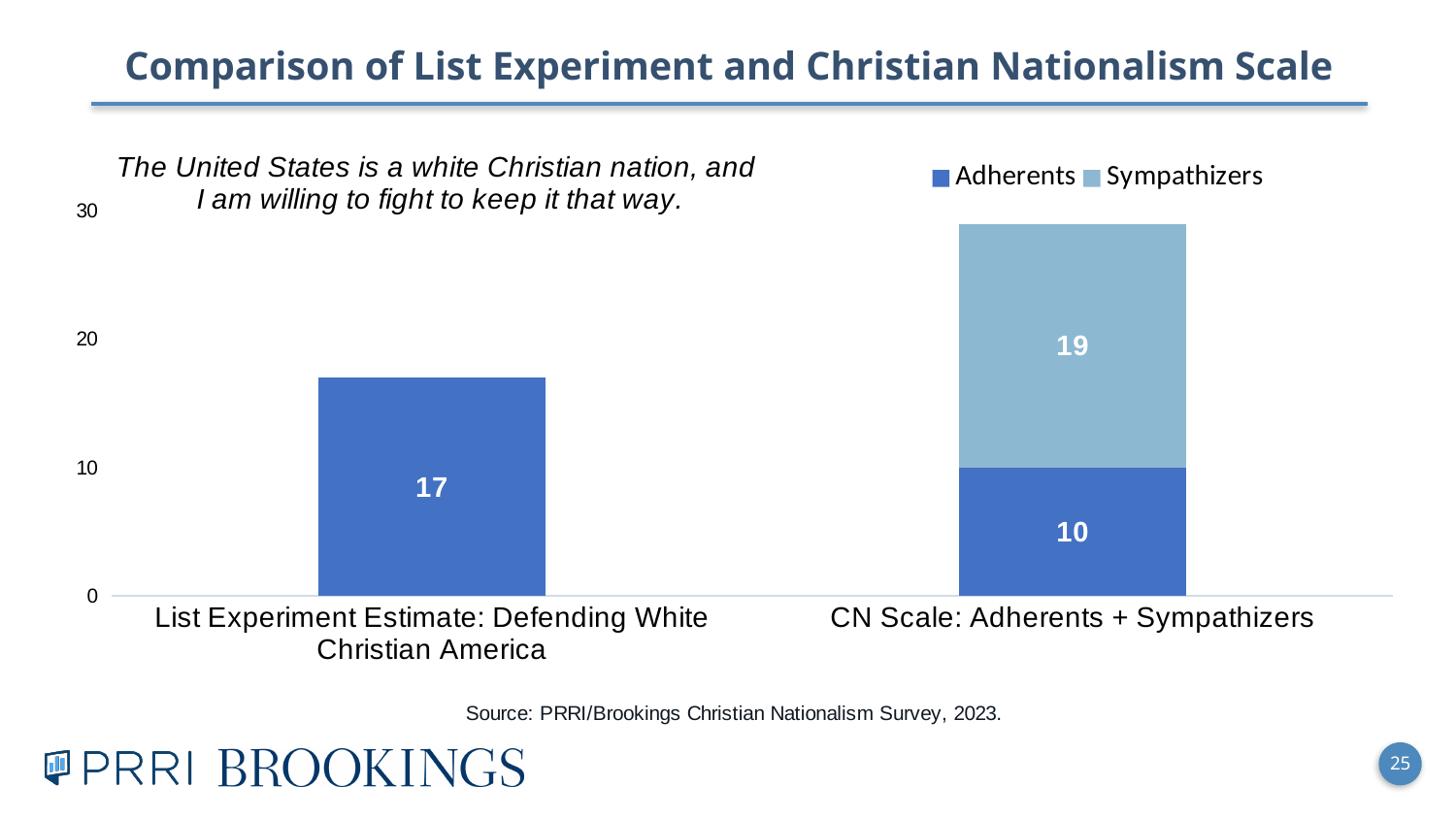
How many series does the legend list? 2 What is the title of the slide's chart? The United States is a white Christian nation, and I am willing to fight to keep it that way. What kind of chart is shown on the slide? Stacked bar chart What is the Adherents value in the CN Scale: Adherents + Sympathizers bar? 10 Is the List Experiment Estimate bar greater or less than 20? less What is the difference between the Sympathizers value and the Adherents value in the CN Scale bar? 9 What is the Sympathizers value in the CN Scale: Adherents + Sympathizers bar? 19 Which is larger: the List Experiment Estimate value or the Adherents value in the CN Scale bar? List Experiment Estimate How many categories are shown on the x axis? 2 What is the value shown for the List Experiment Estimate: Defending White Christian America bar? 17 Is the total height of the CN Scale: Adherents + Sympathizers bar greater or less than 20? greater What is the total of the stacked CN Scale: Adherents + Sympathizers bar? 29